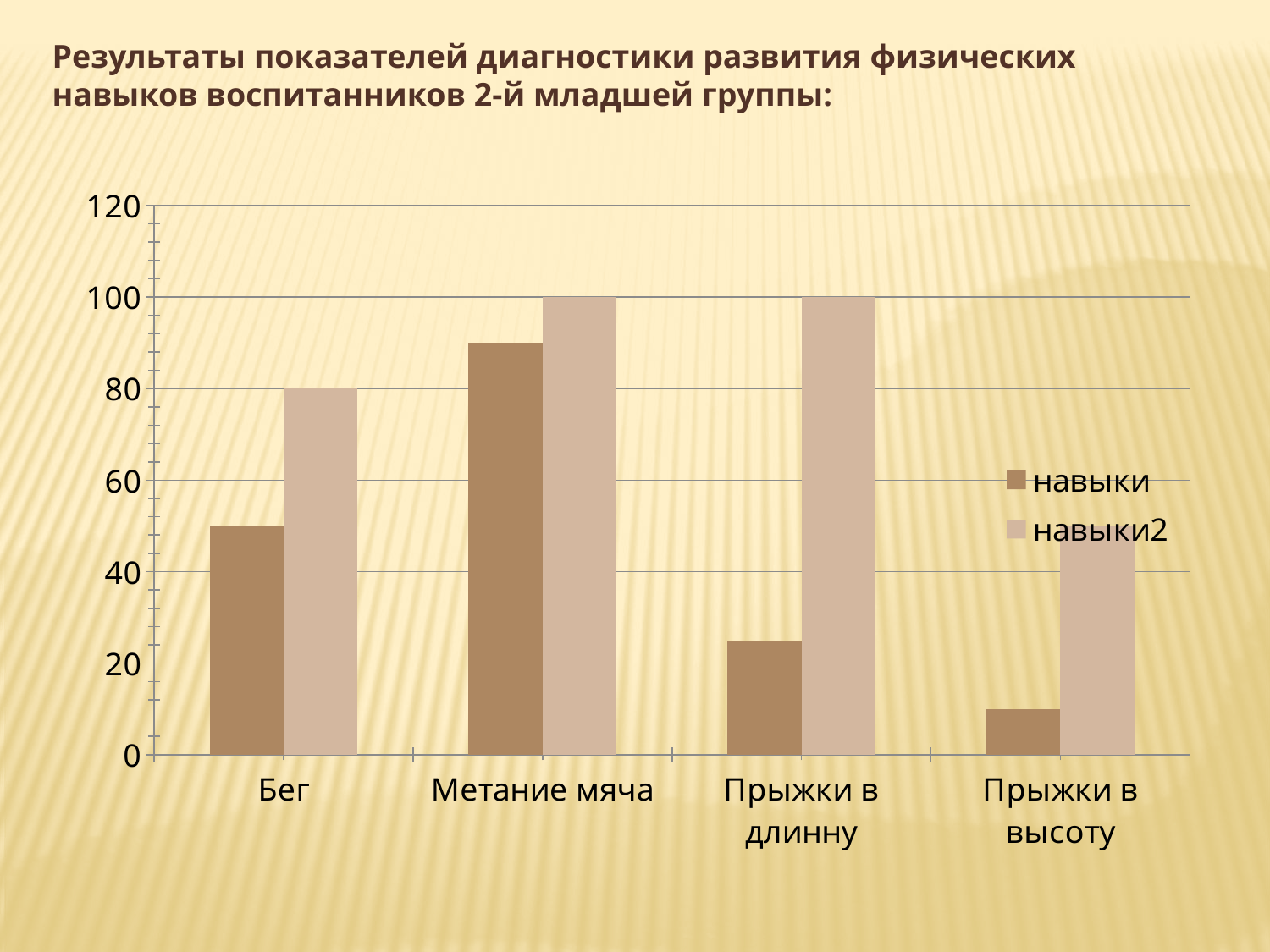
What kind of chart is shown on the slide? bar chart For Прыжки в длинну, which series has the larger value, навыки or навыки2? навыки2 What is the value of навыки2 for Бег? 80 Which category has the highest value for навыки? Метание мяча What is the value of навыки2 for Метание мяча? 100 Is the value of навыки for Бег greater or less than 60? less Is the value of навыки for Прыжки в высоту greater or less than 20? less Is the value of навыки for Метание мяча greater or less than 80? greater Which category has the lowest value for навыки? Прыжки в высоту What are the two series names listed in the legend? навыки, навыки2 How many categories are shown on the x axis? 4 How many series does the legend list? 2